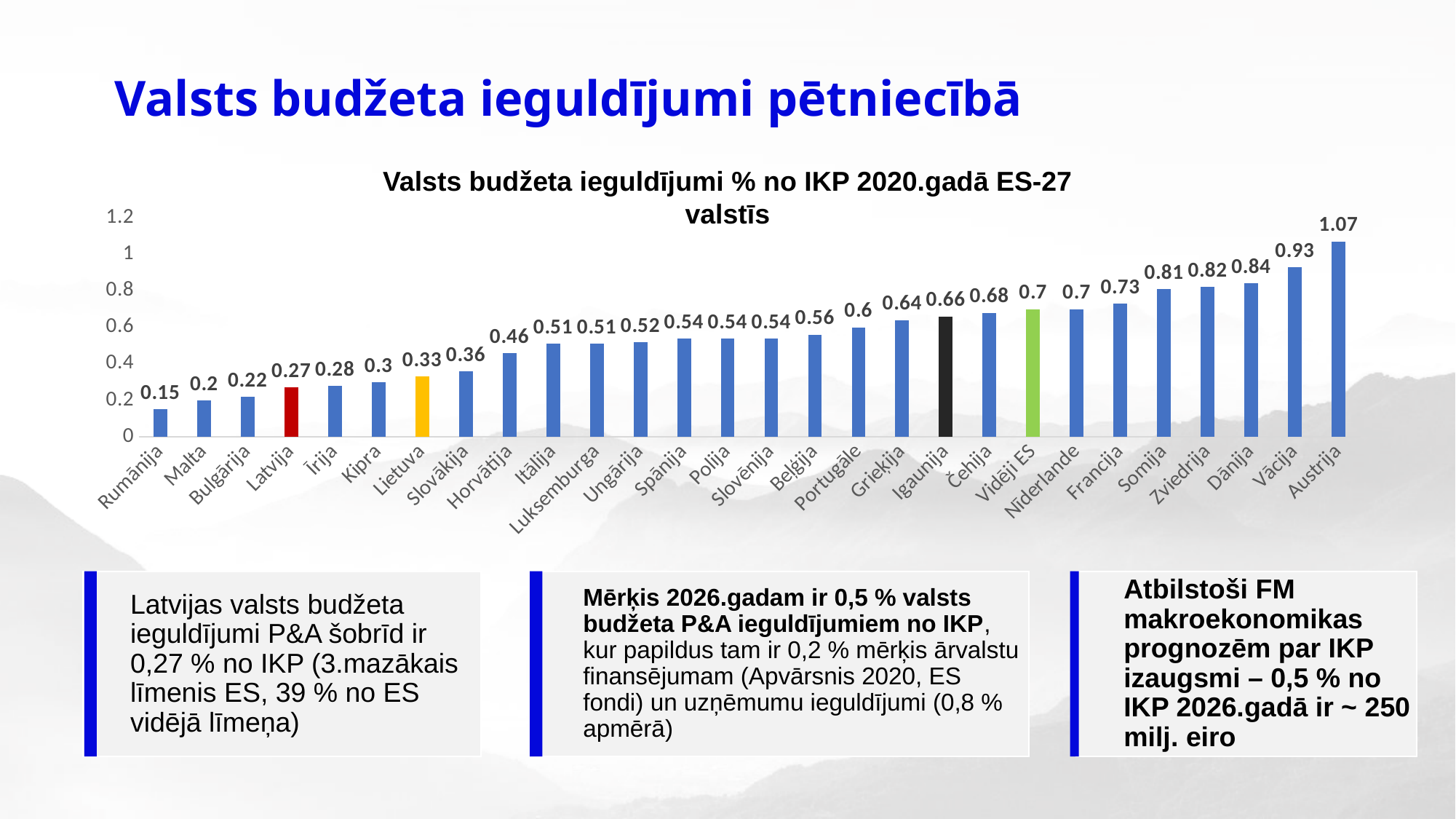
Which country has the highest value in the chart? Austrija What is the value shown for Vidēji ES? 0.7 What is the value for Lietuva? 0.33 What is the difference between the value for Vidēji ES and the value for Latvija? 0.43 What kind of chart is shown on the slide? Bar chart What is the difference between the values for Austrija and Latvija? 0.8 Do the values rise or fall from left to right along the x axis? Rise What colour is the bar for Latvija? Red What is the value for Latvija in the chart? 0.27 Which has a larger value, Vācija or Dānija? Vācija Which country has the lowest value in the chart? Rumānija How many bars are plotted in the chart? 28